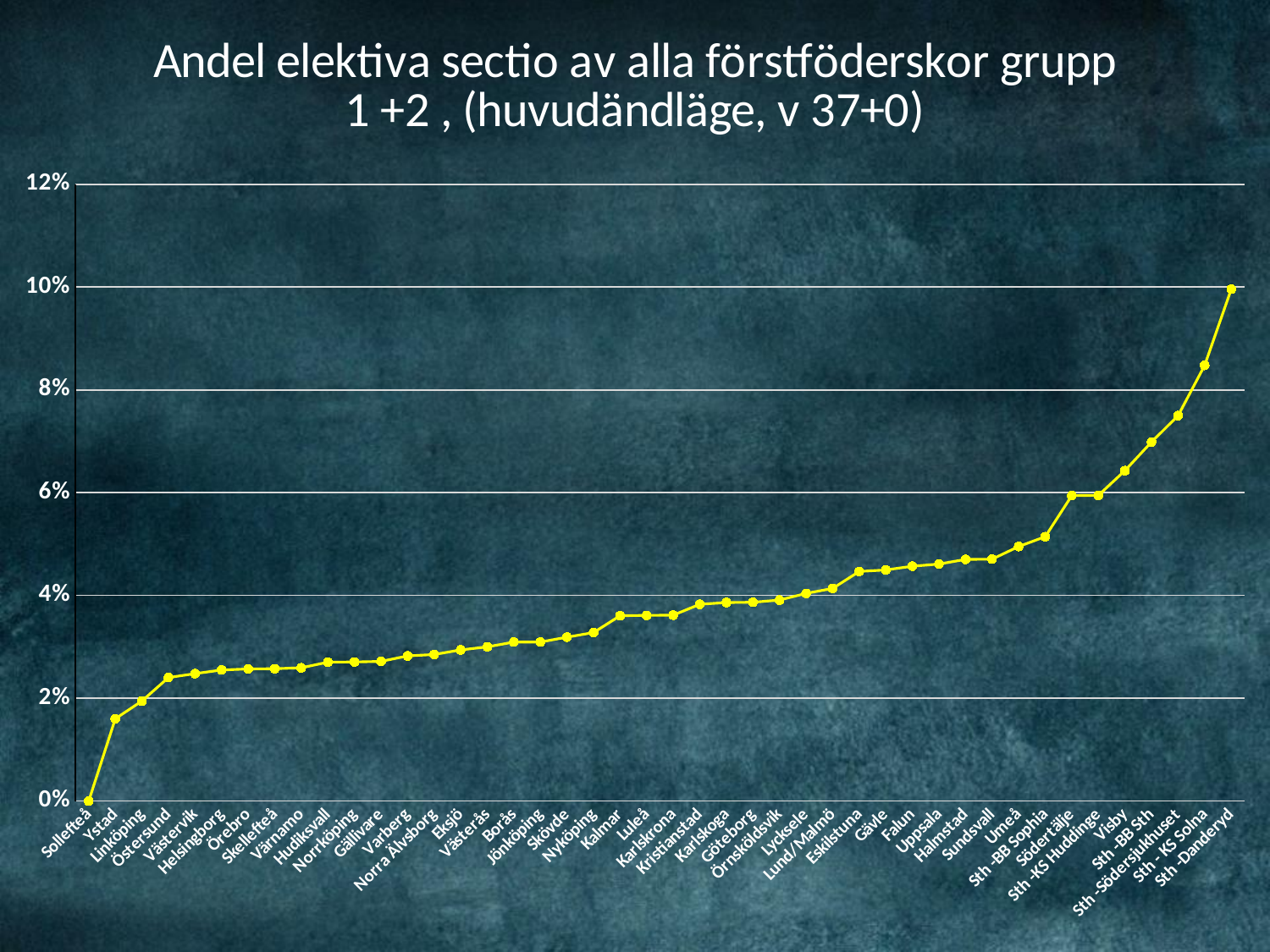
How many hospitals are plotted on the chart? 44 What kind of chart is shown on the slide? line chart Which has a higher value, Umeå or Örebro? Umeå Is the value for Kalmar greater or less than 4%? less Is the value for Visby greater or less than 6%? greater Do the values rise or fall from left to right along the x axis? rise Is the value for Sth - KS Solna greater or less than 8%? greater Which hospital has the highest share of elective sections? Sth -Danderyd What is the value for Sollefteå? 0% Which hospital has the lowest share of elective sections? Sollefteå